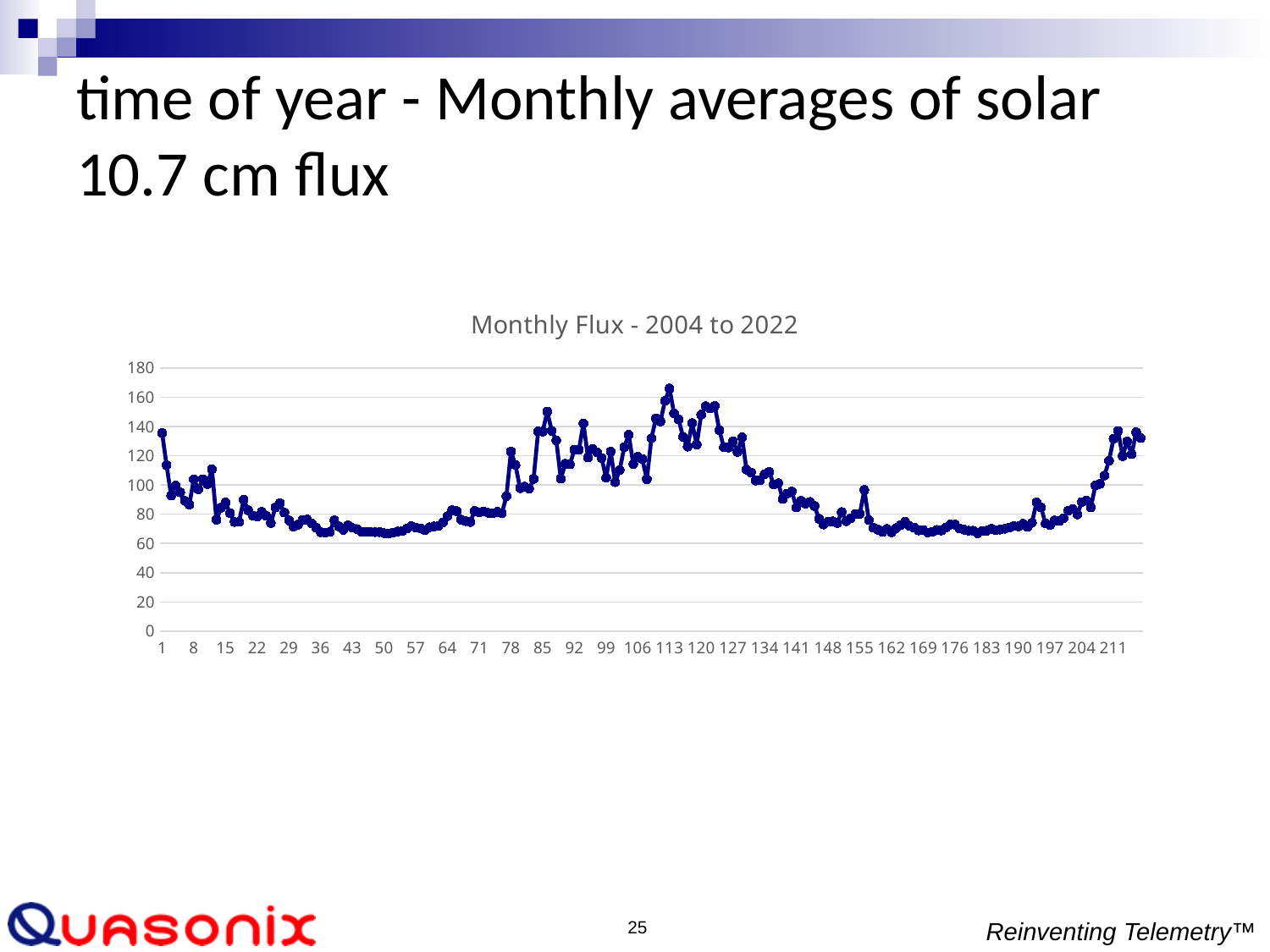
Is the value at point 211 greater or less than 100? greater Which is larger, the value at point 113 or the value at point 169? point 113 What is the title of the chart? Monthly Flux - 2004 to 2022 Is the value at point 1 greater or less than 120? greater Is the value at point 169 greater or less than 80? less Do the values generally rise or fall between point 120 and point 169? fall What kind of chart is shown on the slide? line chart Do the values generally rise or fall between point 78 and point 113? rise Which is larger, the value at point 1 or the value at point 50? point 1 What is the highest value shown on the vertical axis of the chart? 180